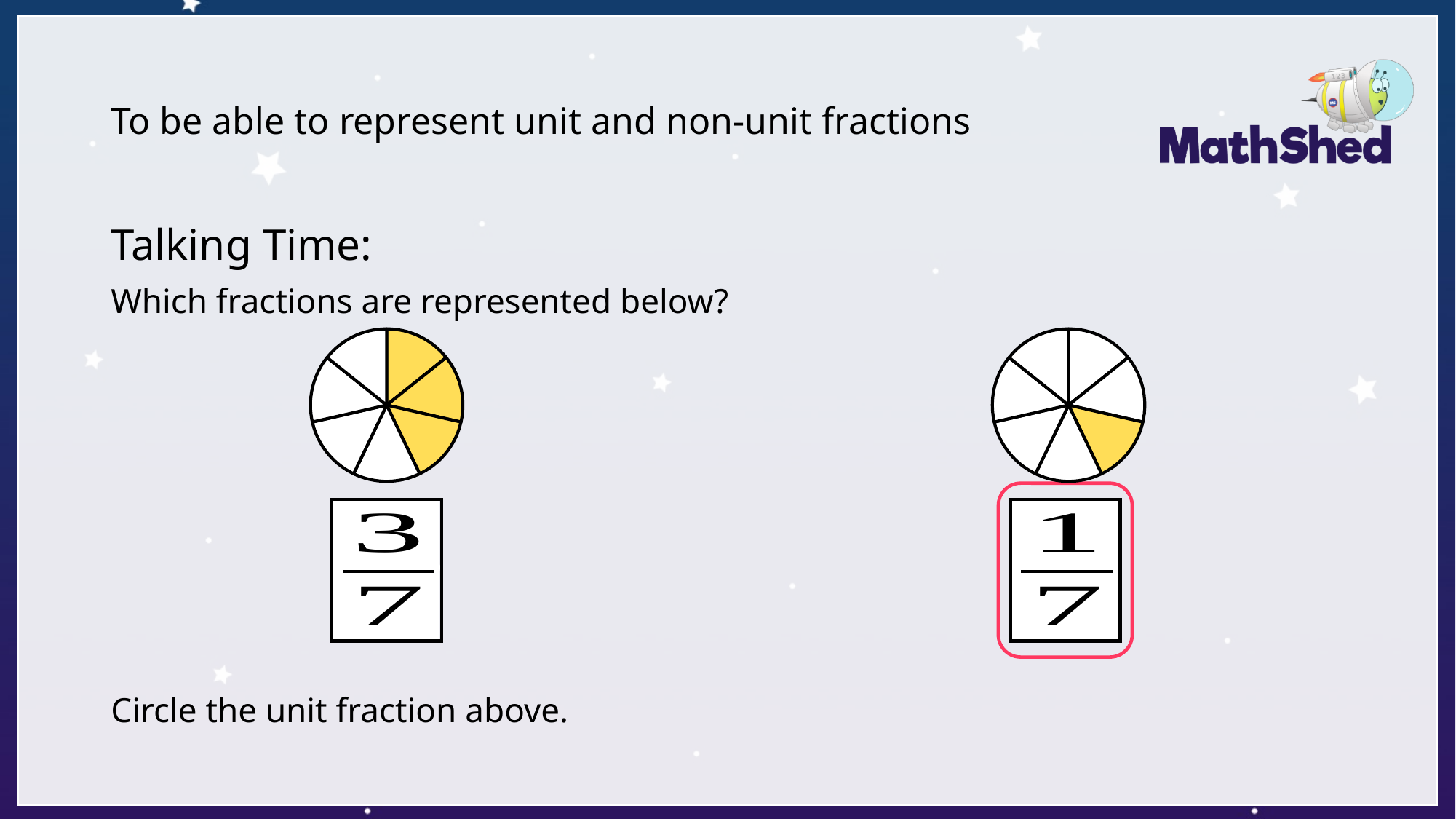
What fraction is written below the left circle? 3/7 What colour are the shaded parts of the circles? yellow Which circle has the smallest shaded share? right How many parts of the right circle are shaded yellow? 1 What fraction is written below the right circle? 1/7 How many parts of the left circle are shaded yellow? 3 Which fraction on the slide is circled in pink? 1/7 Which circle has the larger shaded share, the left or the right? left What share of the right circle is shaded yellow? 1/7 How many equal parts is the left circle divided into? 7 What share of the left circle is shaded yellow? 3/7